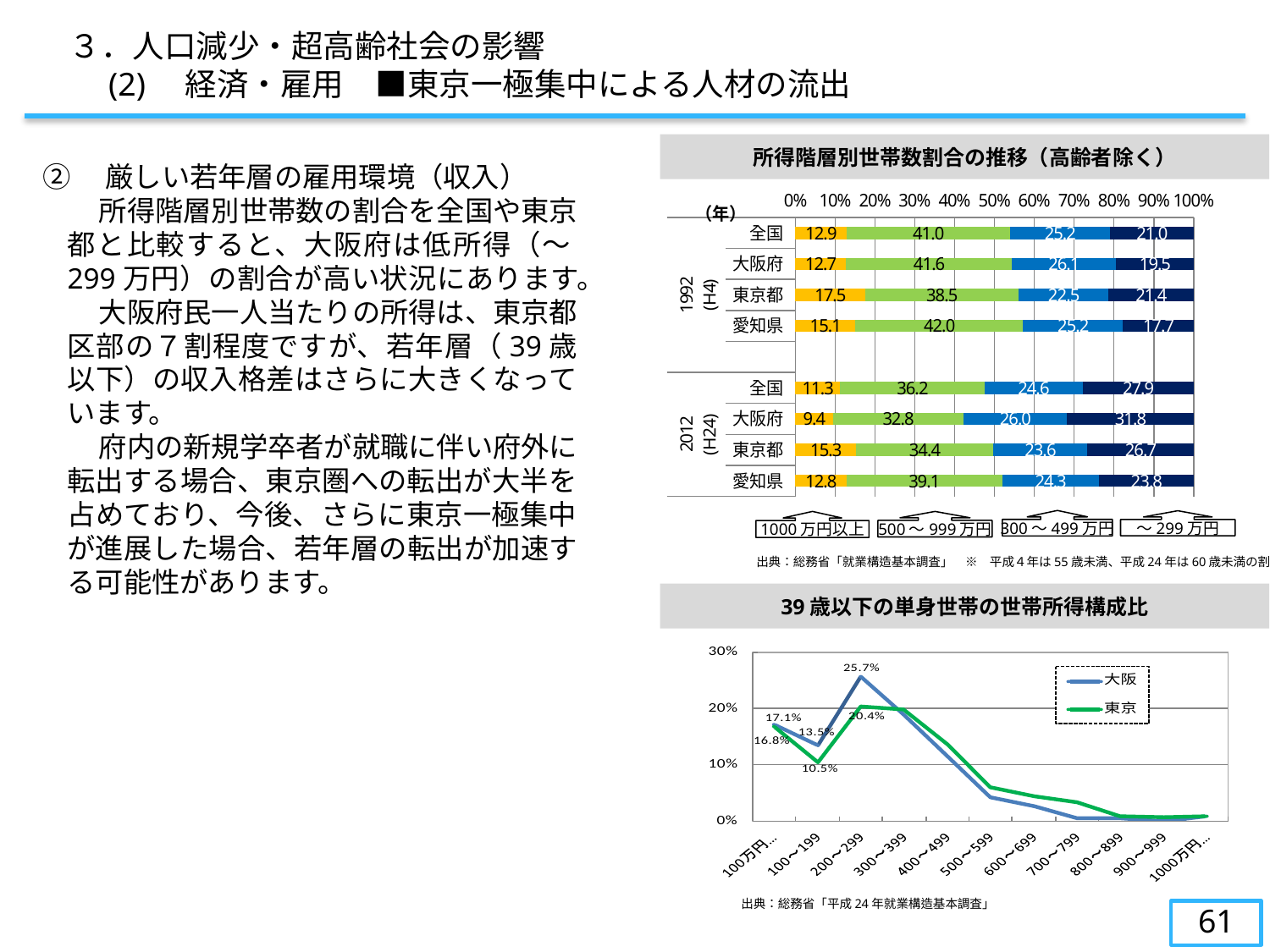
In the top chart (所得階層別世帯数割合の推移), for 1992 (H4), which has the larger green segment: 東京都 or 愛知県? 愛知県 What type of chart is the top chart titled 所得階層別世帯数割合の推移（高齢者除く）? Stacked bar chart In the top chart (所得階層別世帯数割合の推移), what is the value of the dark blue (rightmost) segment for 大阪府 in 2012 (H24)? 31.8 In the bottom chart (39歳以下の単身世帯の世帯所得構成比), how many series does the legend list? 2 In the bottom chart (39歳以下の単身世帯の世帯所得構成比), what is the peak value of the 大阪 line, reached at 200～299? 25.7% In the top chart (所得階層別世帯数割合の推移), what is the value of the yellow (leftmost) segment for 東京都 in 1992 (H4)? 17.5 In the top chart (所得階層別世帯数割合の推移), which region has the smallest yellow (leftmost) segment among the 2012 (H24) bars? 大阪府 In the top chart (所得階層別世帯数割合の推移), by how much did the green segment for 全国 decrease from 1992 (41.0) to 2012 (36.2)? 4.8 In the bottom chart (39歳以下の単身世帯の世帯所得構成比), what are the two legend entries? 大阪 and 東京 What type of chart is the bottom chart titled 39歳以下の単身世帯の世帯所得構成比? Line chart In the top chart (所得階層別世帯数割合の推移), which region has the largest dark blue (rightmost) segment among the 2012 (H24) bars? 大阪府 In the bottom chart (39歳以下の単身世帯の世帯所得構成比), how many income categories are shown on the x axis? 11